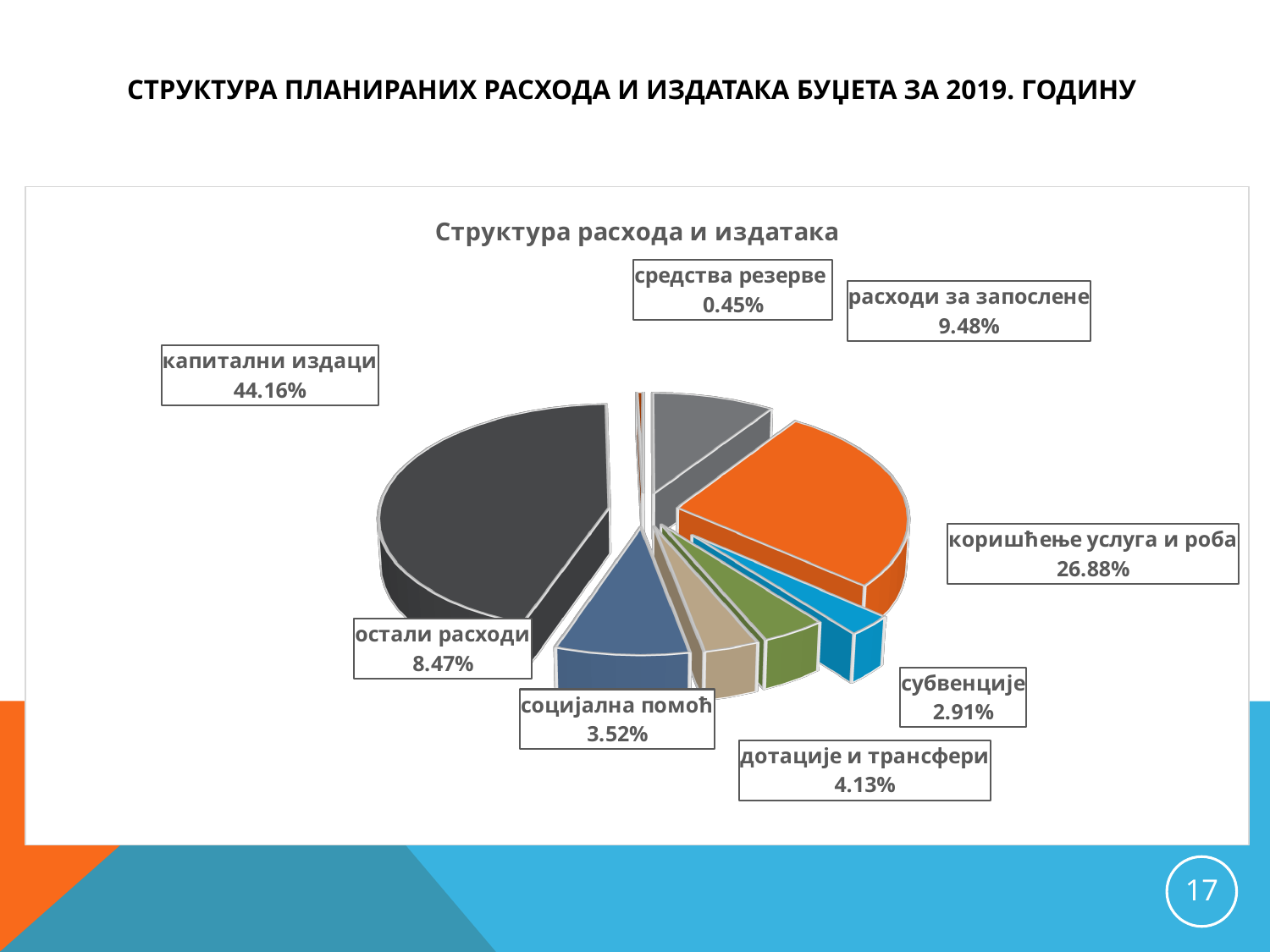
What share of the pie is капитални издаци? 44.16% What is the value shown for средства резерве? 0.45% How many slices does the pie chart have? 8 Which category has the largest share of the pie? капитални издаци What is the difference between the shares of капитални издаци and коришћење услуга и роба? 17.28% Which is larger, the share for расходи за запослене or the share for остали расходи? расходи за запослене What is the value shown for дотације и трансфери? 4.13% What is the difference between the shares of социјална помоћ and субвенције? 0.61% What is the title of the chart? Структура расхода и издатака Which category has the smallest share of the pie? средства резерве What kind of chart is shown on the slide? pie chart What share of the pie is коришћење услуга и роба? 26.88%